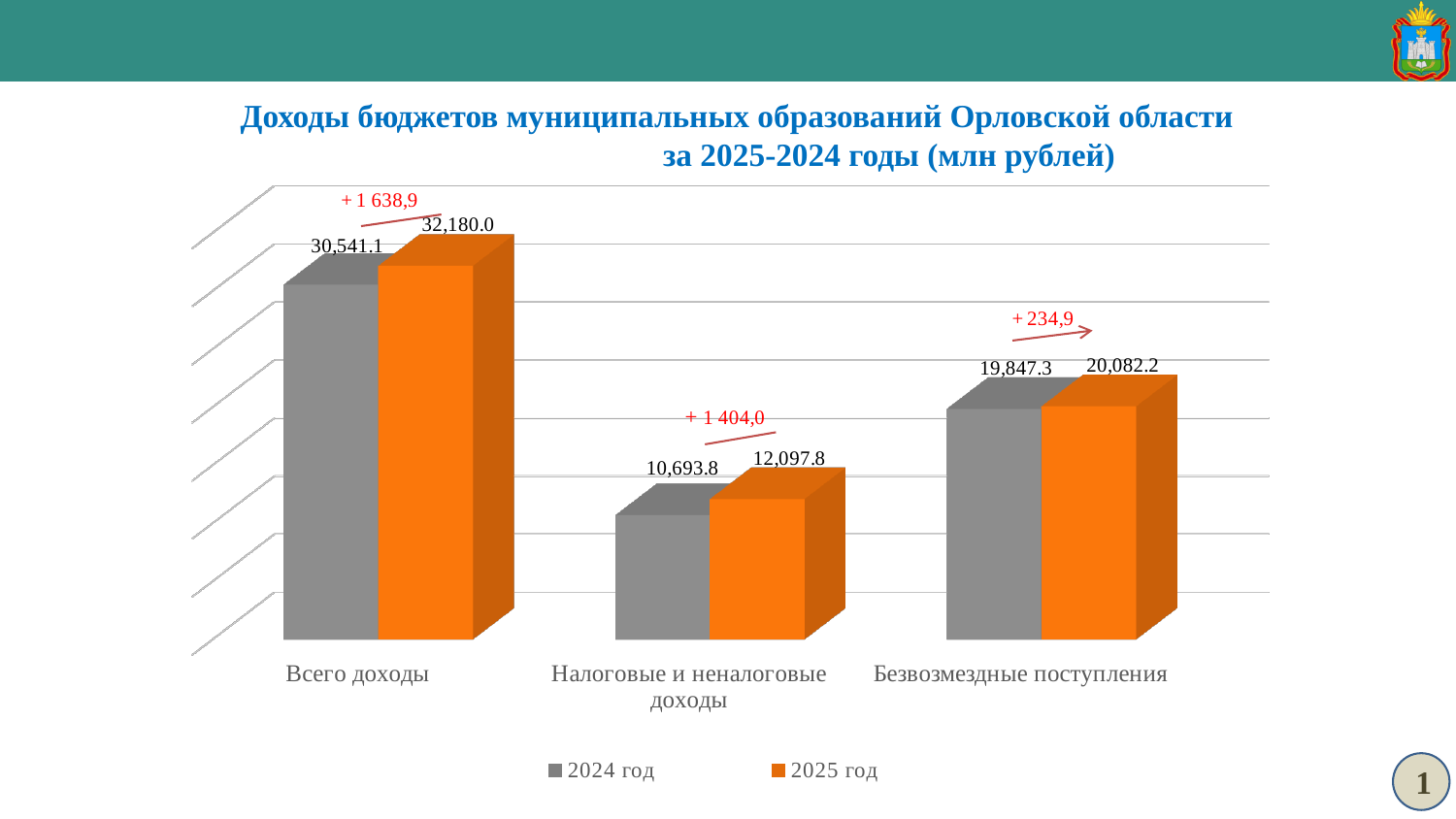
Which is larger: the 2024 год value for Безвозмездные поступления or the 2025 год value for Налоговые и неналоговые доходы? 2024 год value for Безвозмездные поступления What is the value for 2025 год in the Безвозмездные поступления category? 20,082.2 What is the difference between the 2025 год and 2024 год values for Налоговые и неналоговые доходы? 1,404.0 How many categories are shown on the x axis? 3 What is the value for 2024 год in the Всего доходы category? 30,541.1 What is the value for 2025 год in the Всего доходы category? 32,180.0 What is the value for 2024 год in the Налоговые и неналоговые доходы category? 10,693.8 Which category has the lowest value for 2024 год? Налоговые и неналоговые доходы What kind of chart is shown on the slide? Bar chart How many series does the legend list? 2 What is the difference between the 2025 год and 2024 год values for Безвозмездные поступления? 234.9 Which category has the highest value for 2025 год? Всего доходы